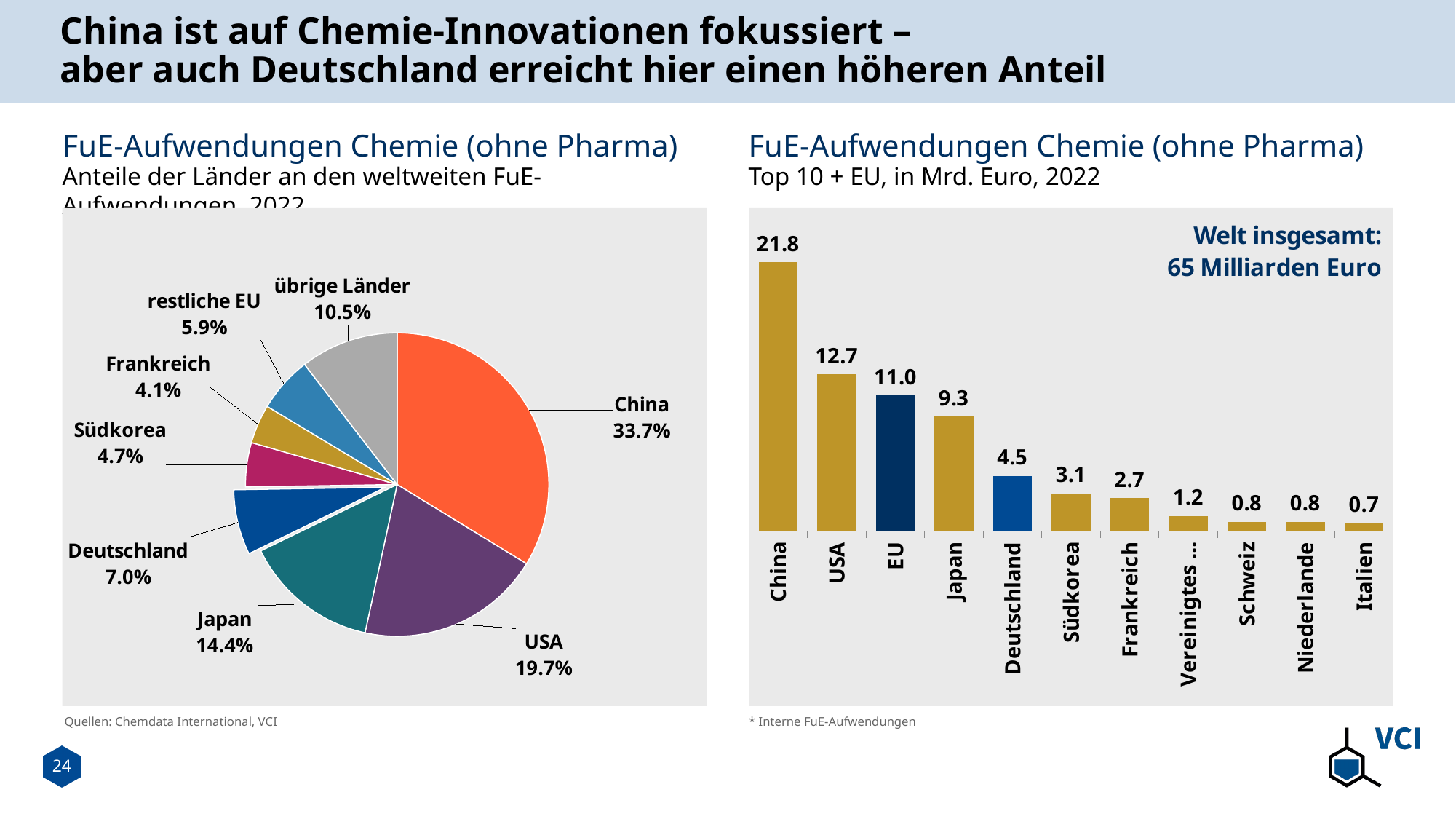
In the pie chart on the left, which labelled slice has the smallest share? Frankreich What type of chart is shown on the right side of the slide? Bar chart In the pie chart on the left, how many slices are there? 8 In the bar chart on the right, how many bars are shown? 11 In the bar chart on the right, what is the difference between the values for USA and EU? 1.7 In the bar chart on the right, which category has the lowest value? Italien In the bar chart on the right, what is the value for Deutschland? 4.5 In the pie chart on the left, which country has the largest share? China In the pie chart on the left, what share does China have of worldwide chemical R&D spending? 33.7% In the bar chart on the right, what is the value for China in billion euros? 21.8 In the pie chart on the left, what share does Deutschland have? 7.0% In the pie chart on the left, what is the difference between the shares of USA and Japan? 5.3%